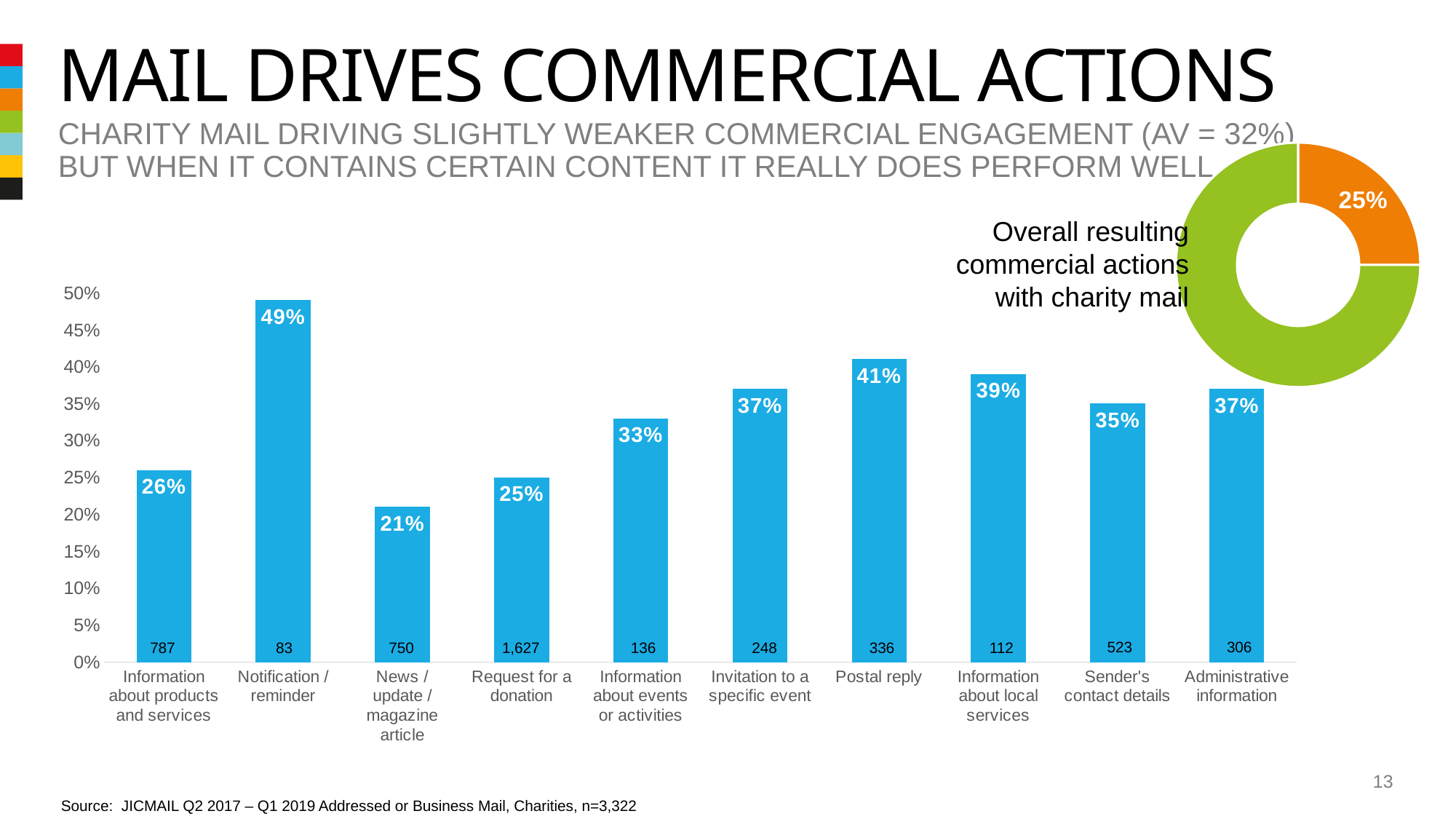
In the bar chart, what is the value for Postal reply? 41% In the bar chart, which is larger: the value for Information about local services or the value for Sender's contact details? Information about local services How many categories does the bar chart show? 10 In the bar chart, what is the value for News / update / magazine article? 21% In the donut chart, what share is shown for the orange slice? 25% In the bar chart, which category has the highest value? Notification / reminder What is the title of the donut chart? Overall resulting commercial actions with charity mail What kind of chart is the chart in the top right of the slide? Donut chart In the bar chart, what is the difference between the values for Notification / reminder and Request for a donation? 24% In the bar chart, which category has the lowest value? News / update / magazine article In the bar chart, what is the value for Notification / reminder? 49% In the bar chart, what number is printed at the base of the Request for a donation bar? 1,627